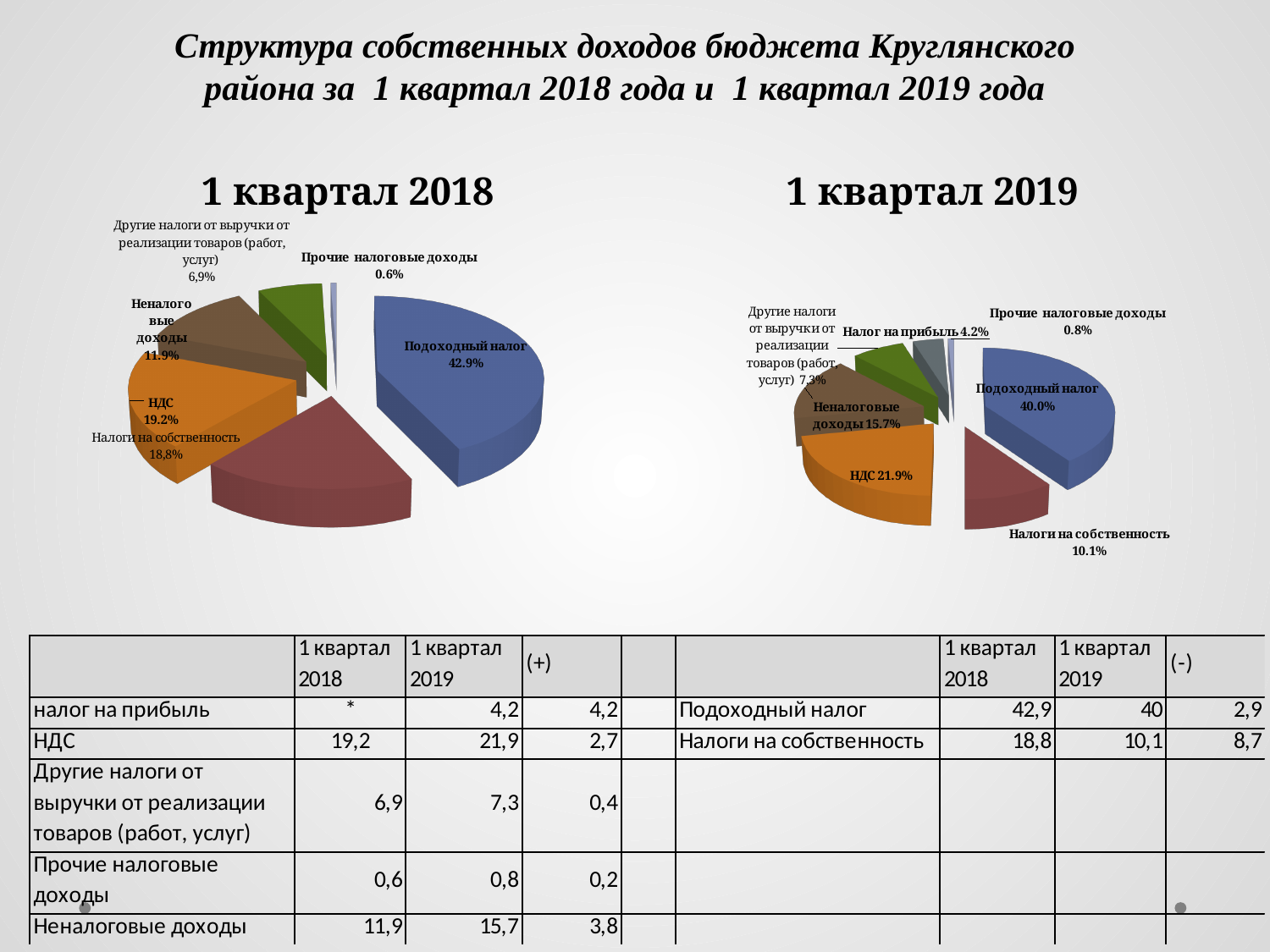
How many slices does the '1 квартал 2018' pie chart have? 6 On the '1 квартал 2018' pie chart, what is the difference between the shares of 'Подоходный налог' and 'НДС'? 23.7% On the '1 квартал 2019' pie chart, which category has the smallest slice? Прочие налоговые доходы How many slices does the '1 квартал 2019' pie chart have? 7 On the '1 квартал 2019' pie chart, which is larger: 'Неналоговые доходы' or 'Налоги на собственность'? Неналоговые доходы On the '1 квартал 2019' pie chart, what share does 'Налог на прибыль' have? 4.2% On the '1 квартал 2018' pie chart, what share does 'Налоги на собственность' have? 18,8% On the '1 квартал 2018' pie chart, which category has the smallest slice? Прочие налоговые доходы On the '1 квартал 2018' pie chart, what share does 'Подоходный налог' have? 42.9% What type of chart is used for '1 квартал 2018'? Pie chart On the '1 квартал 2019' pie chart, what share does 'НДС' have? 21.9% On the '1 квартал 2019' pie chart, which category has the largest slice? Подоходный налог